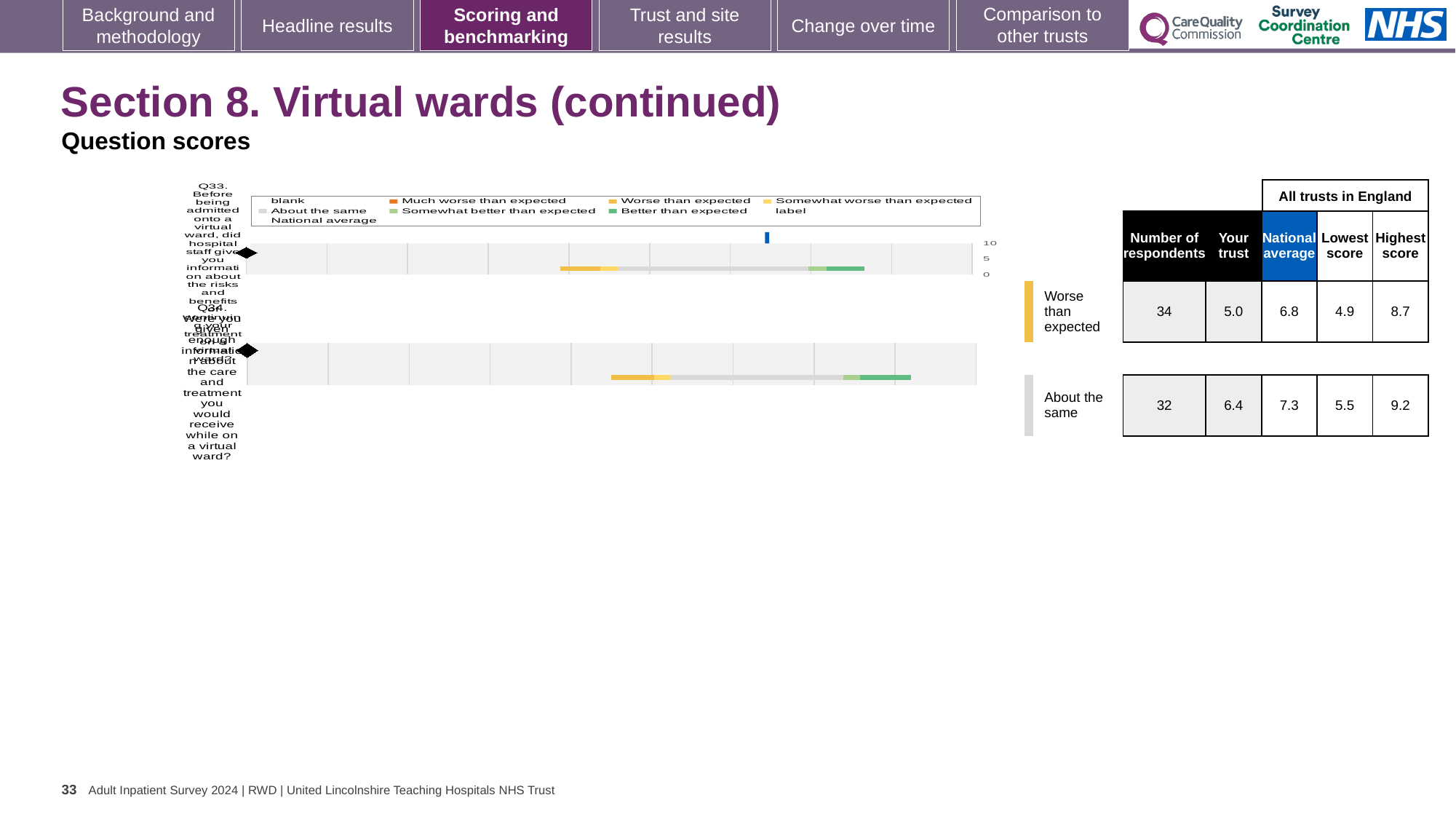
What is the difference between the national average and the trust's score for Q33? 1.8 What is the 'Your trust' score for Q34 (enough information about care and treatment on a virtual ward)? 6.4 How many questions (categories) are plotted in the chart? 2 Which question has the higher 'Your trust' score, Q33 or Q34? Q34 What is the national average score for Q33? 6.8 What is the difference between the highest and lowest scores for Q34? 3.7 Which benchmark category is Q33 rated as? Worse than expected What is the 'Your trust' score for Q33 (information about the risks and benefits of a virtual ward)? 5.0 What kind of chart is used to show the question scores for Q33 and Q34? Bar chart How many respondents answered Q34? 32 What is the highest score among all trusts in England for Q34? 9.2 Which benchmark category is Q34 rated as? About the same